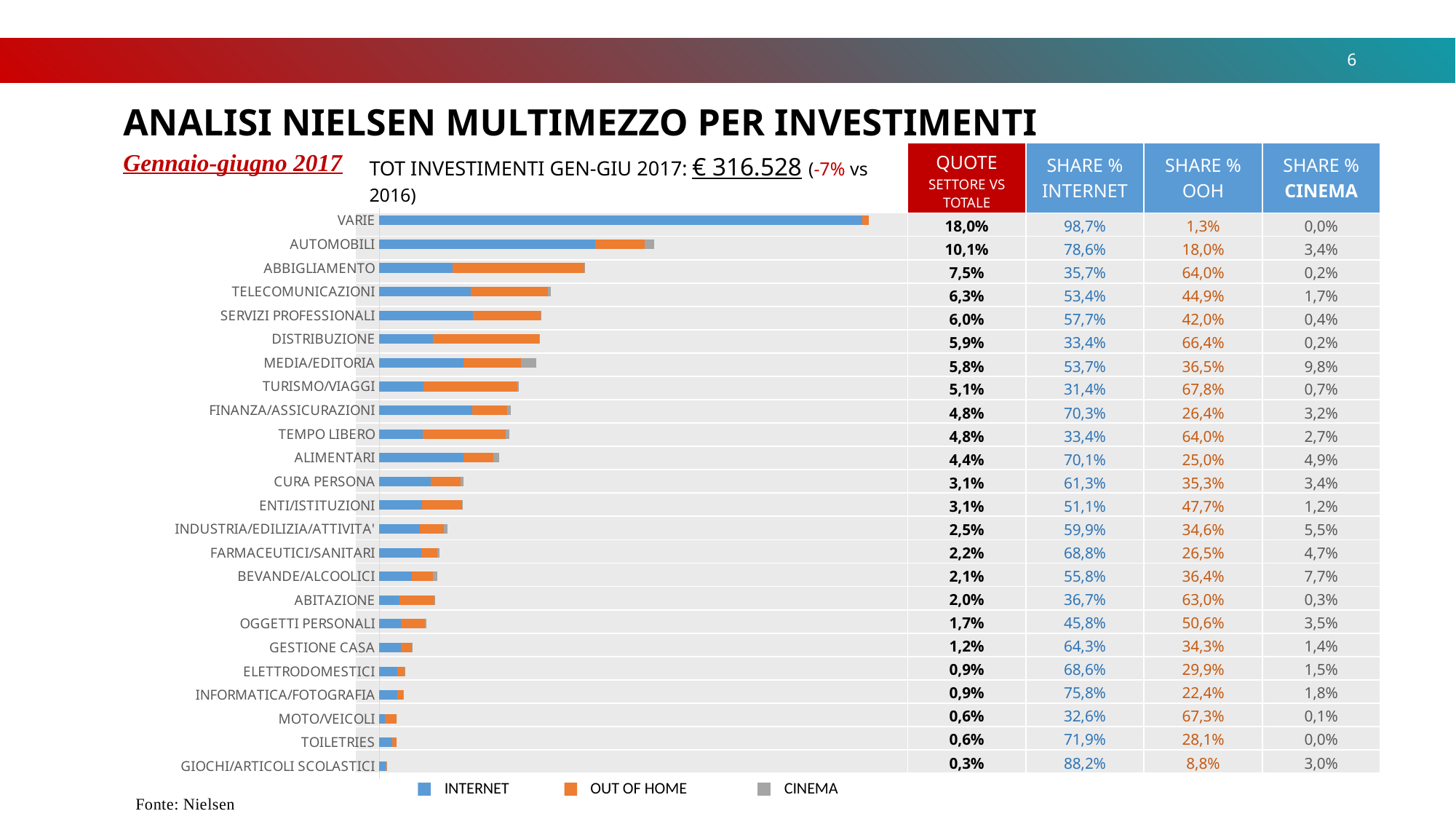
What is the difference between the SHARE % OOH and SHARE % INTERNET values for ABBIGLIAMENTO? 28,3% Which sector has the longest bar in the chart? VARIE How many series does the chart legend list? 3 What is the SHARE % INTERNET value for VARIE? 98,7% Which sector has the shortest bar in the chart? GIOCHI/ARTICOLI SCOLASTICI What is the SHARE % CINEMA value for MEDIA/EDITORIA? 9,8% How many sectors (categories) are plotted in the chart? 24 Which sector has a larger QUOTE SETTORE VS TOTALE, ABBIGLIAMENTO or TELECOMUNICAZIONI? ABBIGLIAMENTO What kind of chart is shown on the slide? Stacked horizontal bar chart Do the bar lengths increase or decrease going from the top of the chart to the bottom? Decrease Which colour represents OUT OF HOME in the chart legend? Orange What is the QUOTE SETTORE VS TOTALE value for AUTOMOBILI? 10,1%